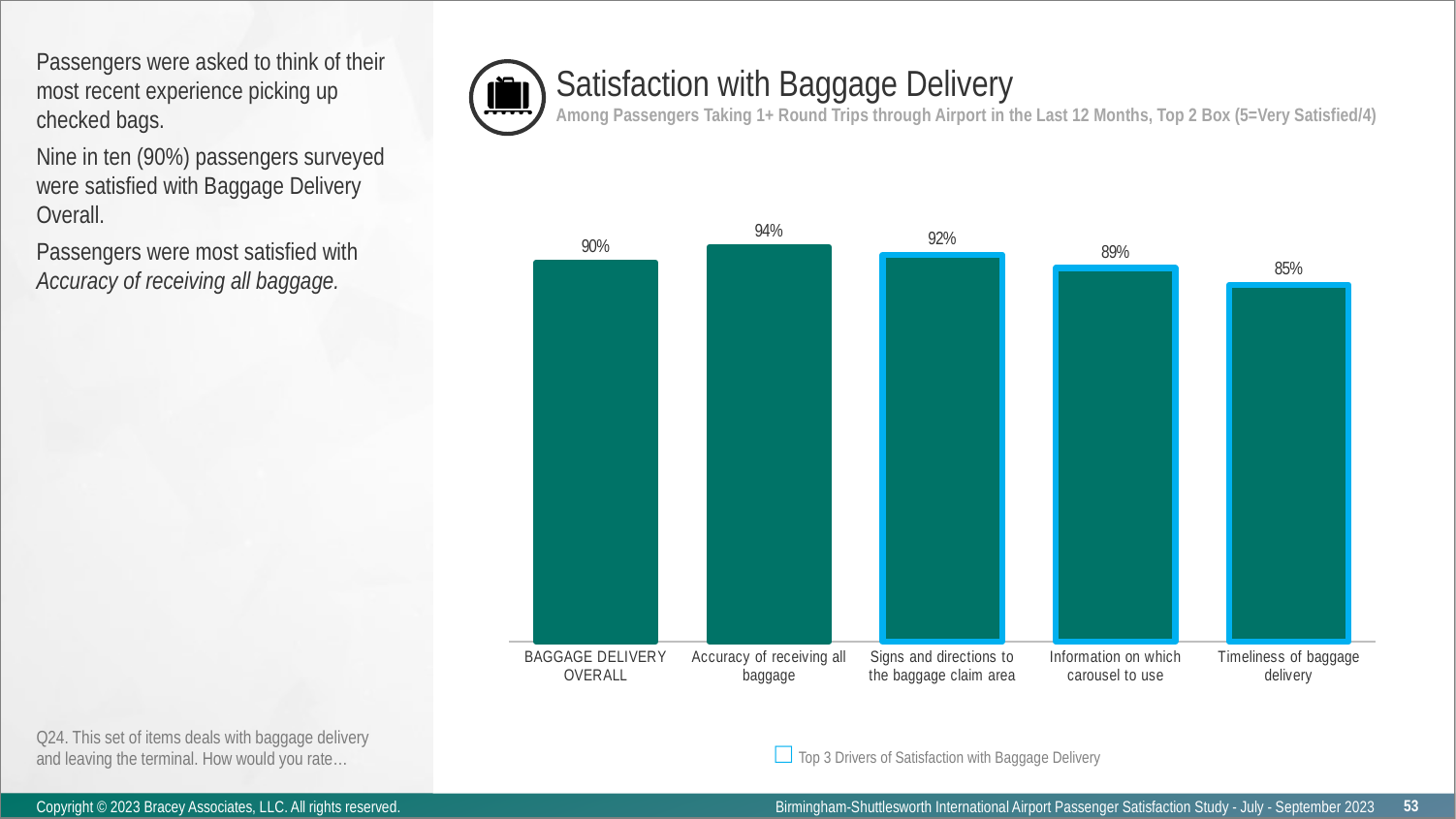
What kind of chart is shown on the slide? Bar chart What is the title of the chart? Satisfaction with Baggage Delivery Which category has the highest value? Accuracy of receiving all baggage Which is larger: Signs and directions to the baggage claim area or Information on which carousel to use? Signs and directions to the baggage claim area What is the value for BAGGAGE DELIVERY OVERALL? 90% How many categories are shown in the chart? 5 Which category has the lowest value? Timeliness of baggage delivery What is the value for Information on which carousel to use? 89% What is the value for Timeliness of baggage delivery? 85% How many bars are outlined in blue as Top 3 Drivers of Satisfaction with Baggage Delivery? 3 What is the value for Accuracy of receiving all baggage? 94% What is the difference between Accuracy of receiving all baggage and Timeliness of baggage delivery? 9%